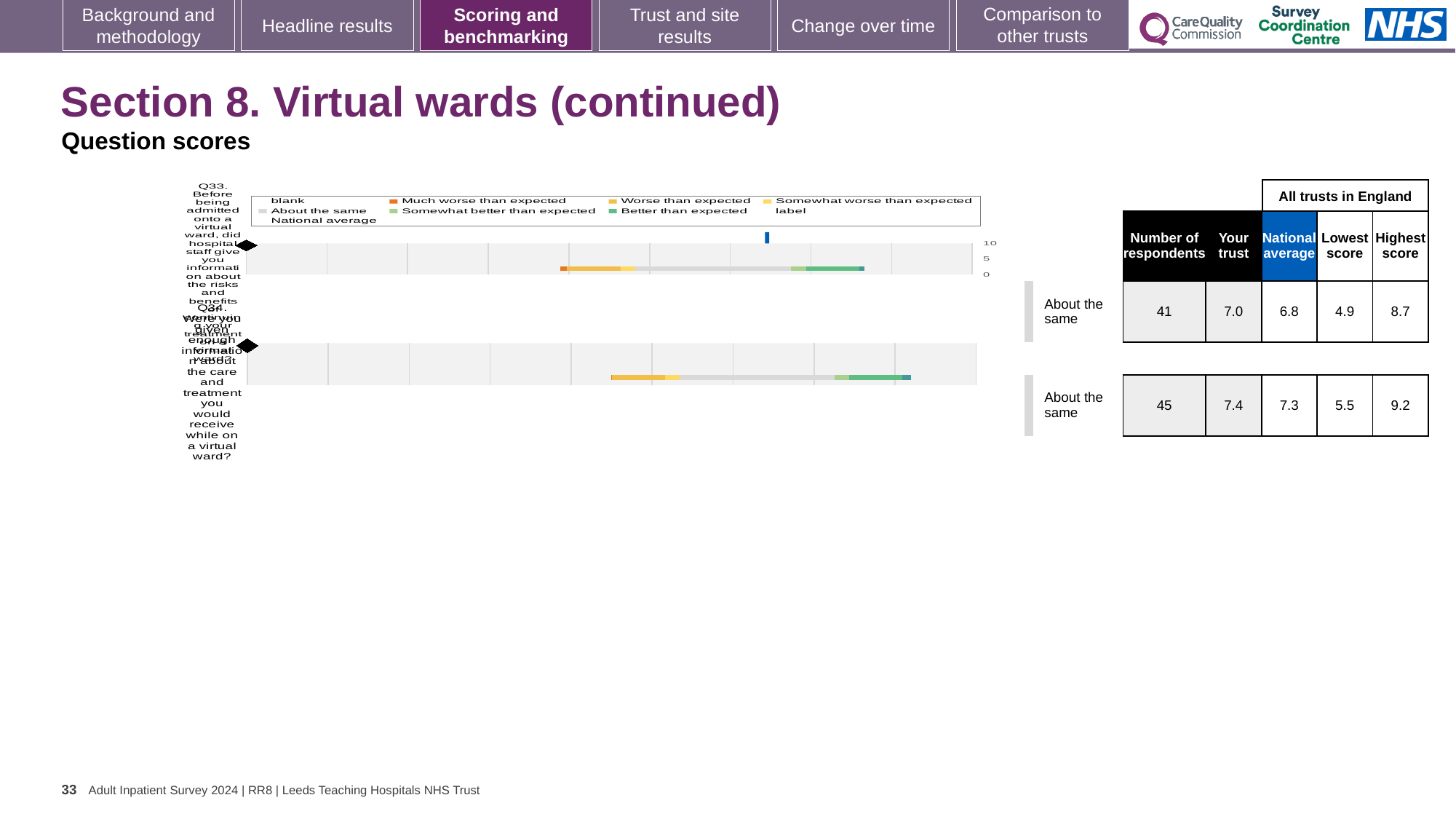
According to the table beside the chart, what is the national average score for Q34? 7.3 According to the table beside the chart, what is the highest score among all trusts in England for Q33? 8.7 According to the table beside the chart, what is the lowest score among all trusts in England for Q34? 5.5 Which legend entry is shown in orange in the chart's legend? Much worse than expected What benchmark category is shown next to the chart for both Q33 and Q34? About the same Which legend entry is shown in dark green in the chart's legend? Better than expected What is the difference between the highest score and the lowest score for Q33 in the table beside the chart? 3.8 How many questions (bars) are plotted in the chart? 2 According to the table beside the chart, how many respondents answered Q34? 45 Which question has the higher 'Your trust' score in the table beside the chart, Q33 or Q34? Q34 What kind of chart is used to show the question scores for Q33 and Q34? bar chart According to the table beside the chart, what is the 'Your trust' score for Q33? 7.0